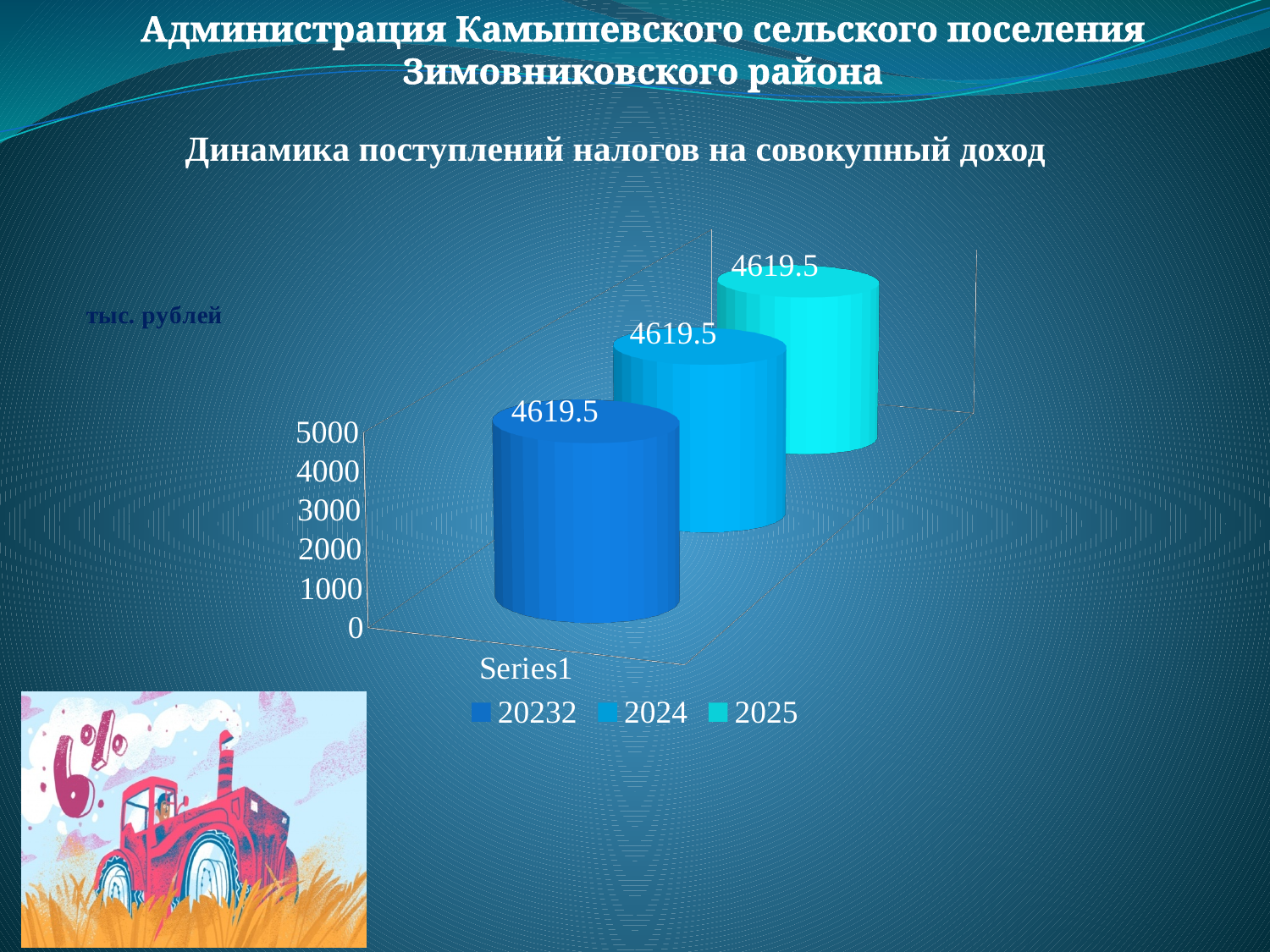
What is the value for 2024 in the chart? 4619.5 Do the values rise, fall or stay the same across the three series from 20232 to 2025? stay the same What kind of chart is shown on the slide? bar chart What is the value for the series labelled 20232 in the chart? 4619.5 How many series does the chart legend list? 3 What unit is indicated for the chart values? тыс. рублей Is the value for 2024 greater or less than 5000? less What is the title of the chart? Динамика поступлений налогов на совокупный доход What is the difference between the values for 2024 and 2025? 0 Is the value for 2025 greater or less than 4000? greater What is the value for 2025 in the chart? 4619.5 How many categories are shown on the x axis of the chart? 1